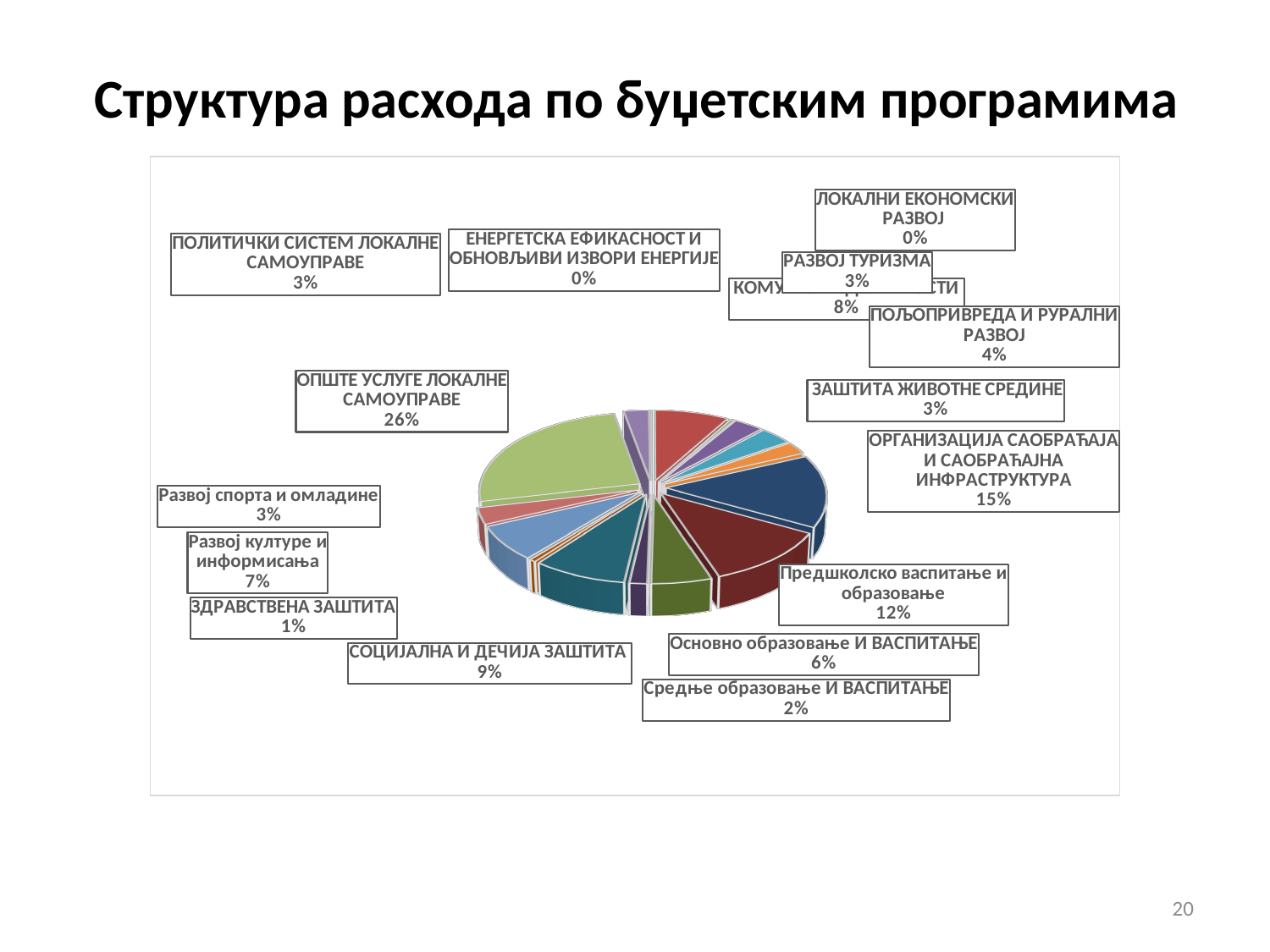
What percentage is shown for Развој културе и информисања? 7% What is the difference in percentage points between ОПШТЕ УСЛУГЕ ЛОКАЛНЕ САМОУПРАВЕ and ОРГАНИЗАЦИЈА САОБРАЋАЈА И САОБРАЋАЈНА ИНФРАСТРУКТУРА? 11 percentage points What percentage is shown for Предшколско васпитање и образовање? 12% What kind of chart is shown on the slide? Pie chart What percentage is shown for ПОЉОПРИВРЕДА И РУРАЛНИ РАЗВОЈ? 4% What share of expenditure goes to ОПШТЕ УСЛУГЕ ЛОКАЛНЕ САМОУПРАВЕ? 26% What percentage is shown for СОЦИЈАЛНА И ДЕЧИЈА ЗАШТИТА? 9% What is the title of the chart on the slide? Структура расхода по буџетским програмима What percentage is shown for ЗДРАВСТВЕНА ЗАШТИТА? 1% Which budget programme has the largest share of expenditure? ОПШТЕ УСЛУГЕ ЛОКАЛНЕ САМОУПРАВЕ Which has a larger share: Основно образовање И ВАСПИТАЊЕ or Средње образовање И ВАСПИТАЊЕ? Основно образовање И ВАСПИТАЊЕ What percentage is shown for ОРГАНИЗАЦИЈА САОБРАЋАЈА И САОБРАЋАЈНА ИНФРАСТРУКТУРА? 15%